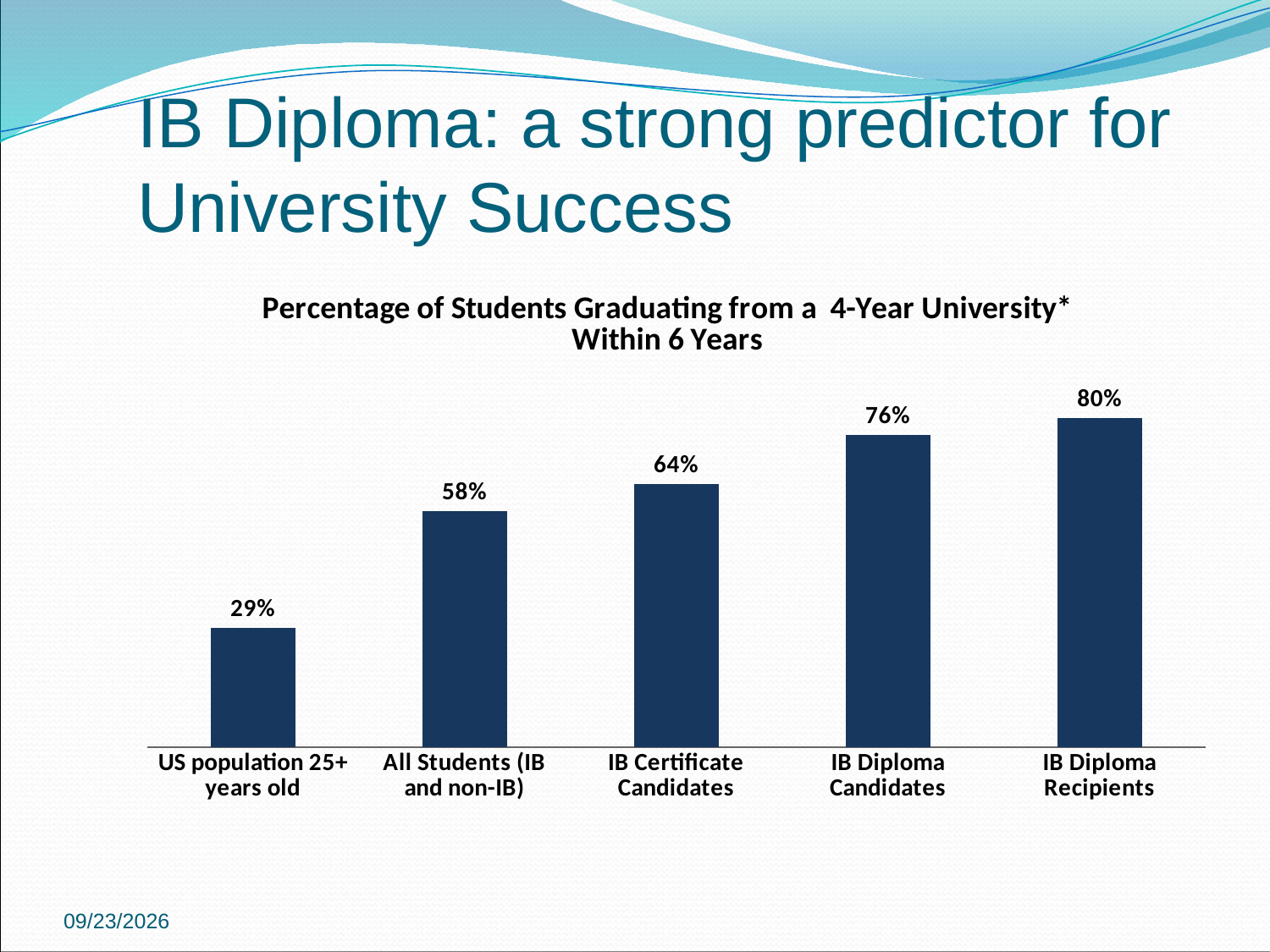
What kind of chart is shown on the slide? Bar chart What is the difference between the values for IB Diploma Candidates and IB Certificate Candidates? 12% Which is larger, the value for IB Diploma Candidates or the value for All Students (IB and non-IB)? IB Diploma Candidates What is the value for All Students (IB and non-IB)? 58% Which category has the lowest value? US population 25+ years old How many categories are shown in the chart? 5 What is the value for IB Diploma Recipients? 80% What is the value for US population 25+ years old? 29% Do the values rise or fall from left to right across the categories? Rise What is the difference between the values for IB Diploma Recipients and US population 25+ years old? 51% Which category has the highest value? IB Diploma Recipients What is the value for IB Certificate Candidates? 64%